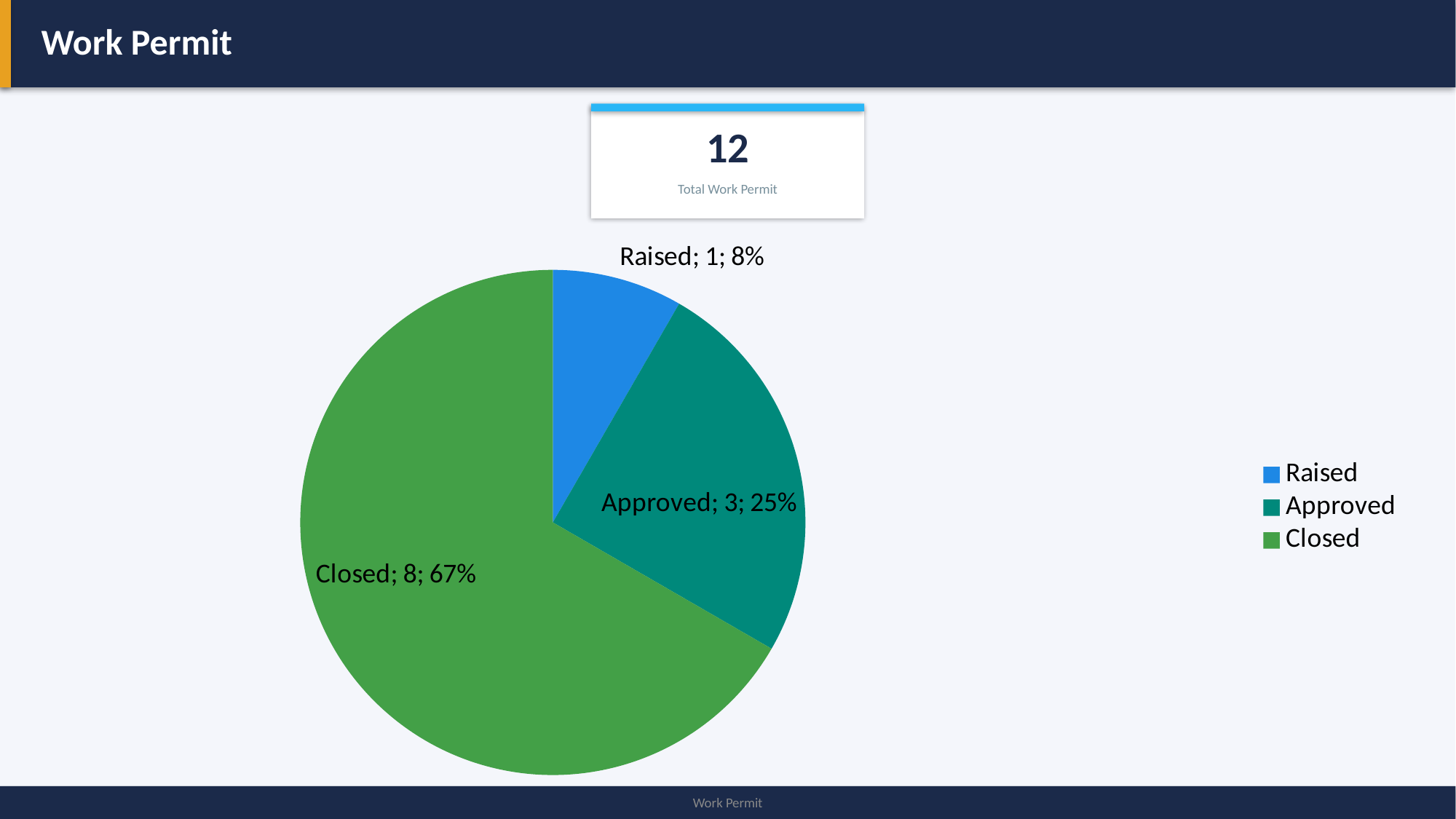
How many work permits are Raised? 1 Which is larger, the Approved slice or the Raised slice? Approved Which category has the smallest slice of the pie? Raised What share of the pie does the Approved slice represent? 25% How many work permits are Approved? 3 What is the difference between the number of Closed and Approved work permits? 5 Which category has the largest slice of the pie? Closed How many work permits are Closed? 8 What share of the pie does the Raised slice represent? 8% What kind of chart is shown on the slide? pie chart How many categories does the legend list? 3 What share of the pie does the Closed slice represent? 67%